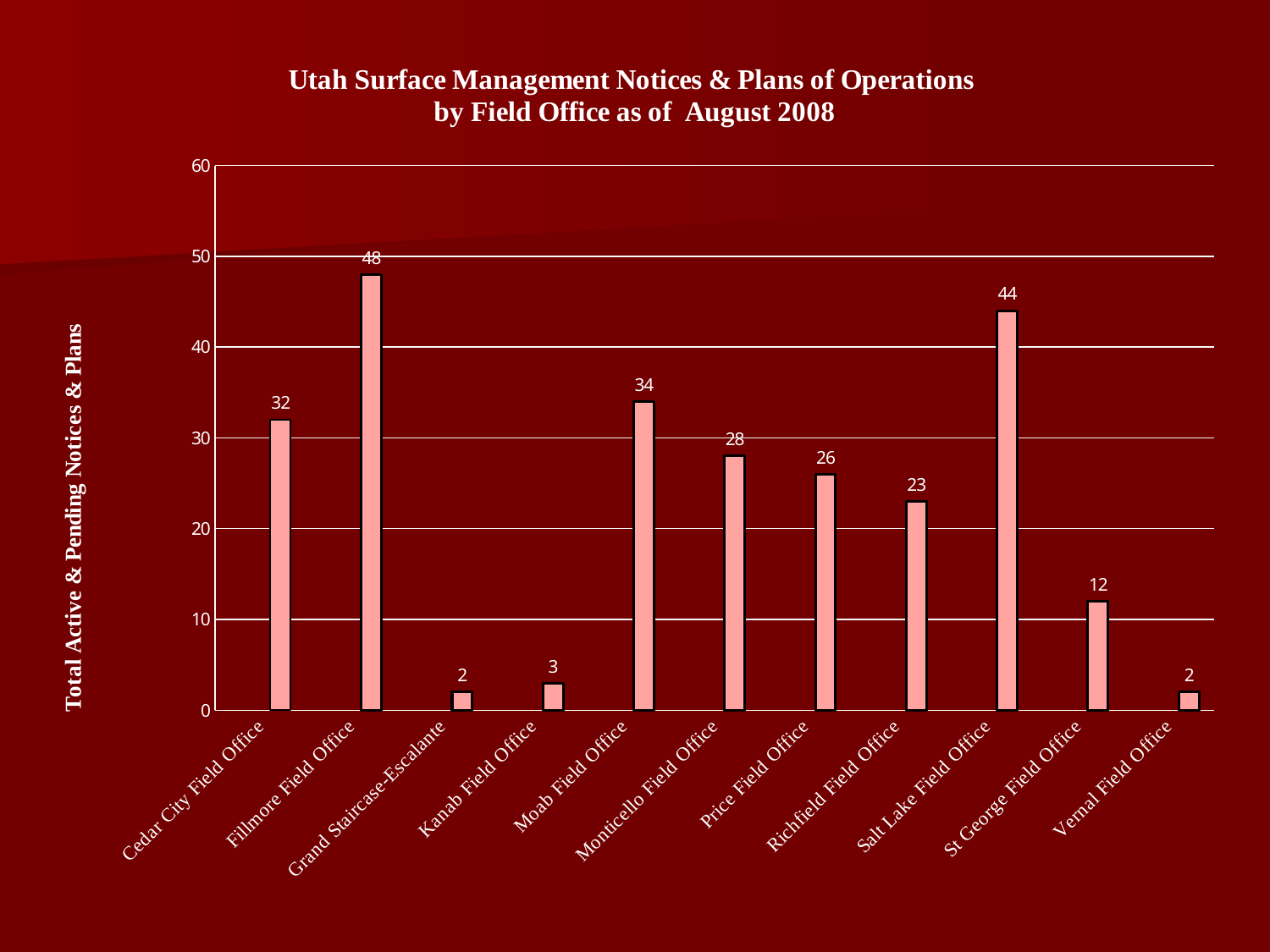
What is the label of the y axis? Total Active & Pending Notices & Plans Which field office has the highest value? Fillmore Field Office How many field offices are shown on the x axis? 11 What is the title of the chart? Utah Surface Management Notices & Plans of Operations by Field Office as of August 2008 What is the value for St George Field Office? 12 Is the value for Cedar City Field Office greater or less than 30? greater What is the value for Fillmore Field Office? 48 What kind of chart is shown on the slide? Bar chart What is the difference between the values for Salt Lake Field Office and Richfield Field Office? 21 Which field office has the lowest value, Grand Staircase-Escalante or Kanab Field Office? Grand Staircase-Escalante Which is larger, the value for Monticello Field Office or the value for Price Field Office? Monticello Field Office What is the value for Moab Field Office? 34